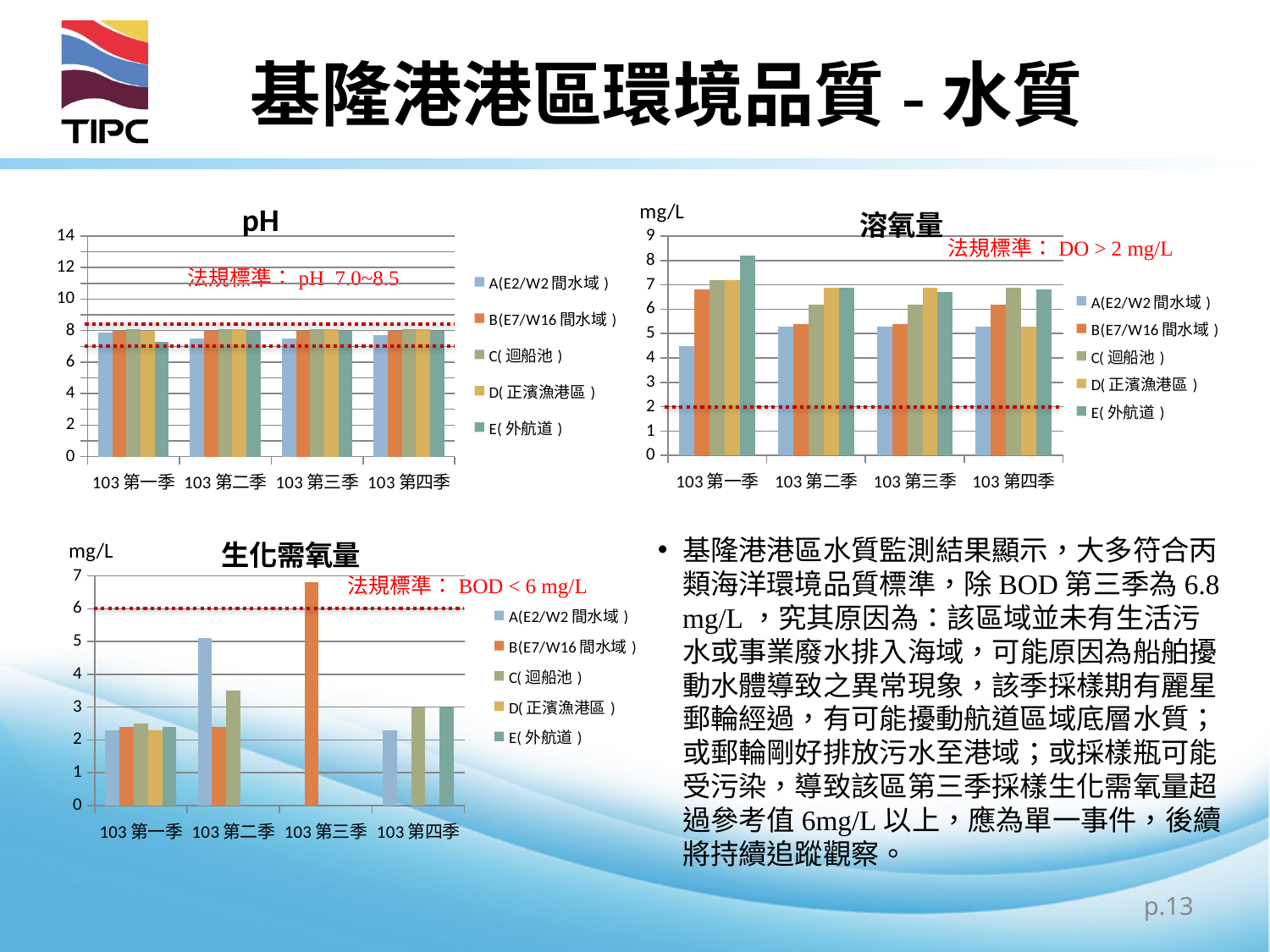
In the 溶氧量 chart, which series has the highest value in 103 第一季? E(外航道) In the 生化需氧量 chart, which is larger in 103 第二季: A(E2/W2間水域) or C(迴船池)? A(E2/W2間水域) In the 生化需氧量 chart, which series has the highest value in 103 第三季? B(E7/W16間水域) What legal standard (法規標準) is stated on the 溶氧量 chart? DO > 2 mg/L In the 溶氧量 chart, is the value for E(外航道) in 103 第一季 greater or less than 7? greater What kind of chart is the pH chart? bar chart How many categories are shown on the x axis of the 生化需氧量 chart? 4 In the 生化需氧量 chart, is the value for B(E7/W16間水域) in 103 第三季 greater or less than 6? greater In the 溶氧量 chart, which is larger in 103 第二季: D(正濱漁港區) or A(E2/W2間水域)? D(正濱漁港區) In the 溶氧量 chart, which series has the lowest value in 103 第一季? A(E2/W2間水域) How many series does the legend of the 溶氧量 chart list? 5 In the pH chart, is the value for A(E2/W2間水域) in 103 第一季 greater or less than 6? greater